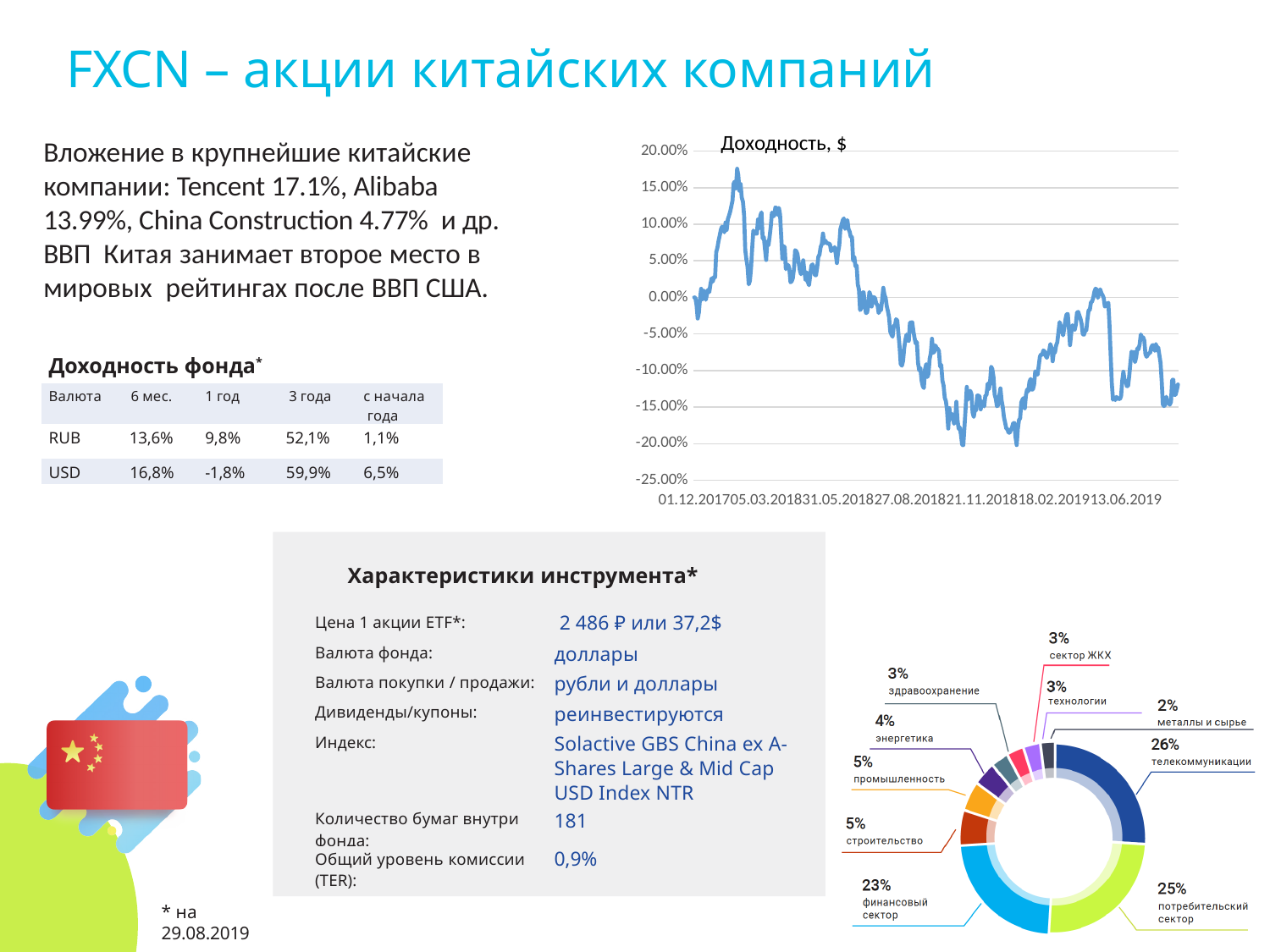
What kind of chart is the sector allocation chart in the bottom right of the slide? pie chart (donut) In the sector chart in the bottom right, which is larger: the share of строительство or the share of энергетика? строительство In the chart titled "Доходность, $", is the highest point of the line greater or less than 15.00%? greater In the sector chart in the bottom right, what is the difference between the shares of потребительский сектор and финансовый сектор? 2% In the sector chart in the bottom right, what share does телекоммуникации have? 26% What kind of chart is the chart titled "Доходность, $"? line chart In the chart titled "Доходность, $", is the lowest point of the line greater or less than -15.00%? less In the sector chart in the bottom right, what share does финансовый сектор have? 23% In the sector chart in the bottom right, which sector has the smallest share? металлы и сырье How many sectors are shown in the sector chart in the bottom right? 10 In the sector chart in the bottom right, what share does энергетика have? 4% In the sector chart in the bottom right, which sector has the largest share? телекоммуникации